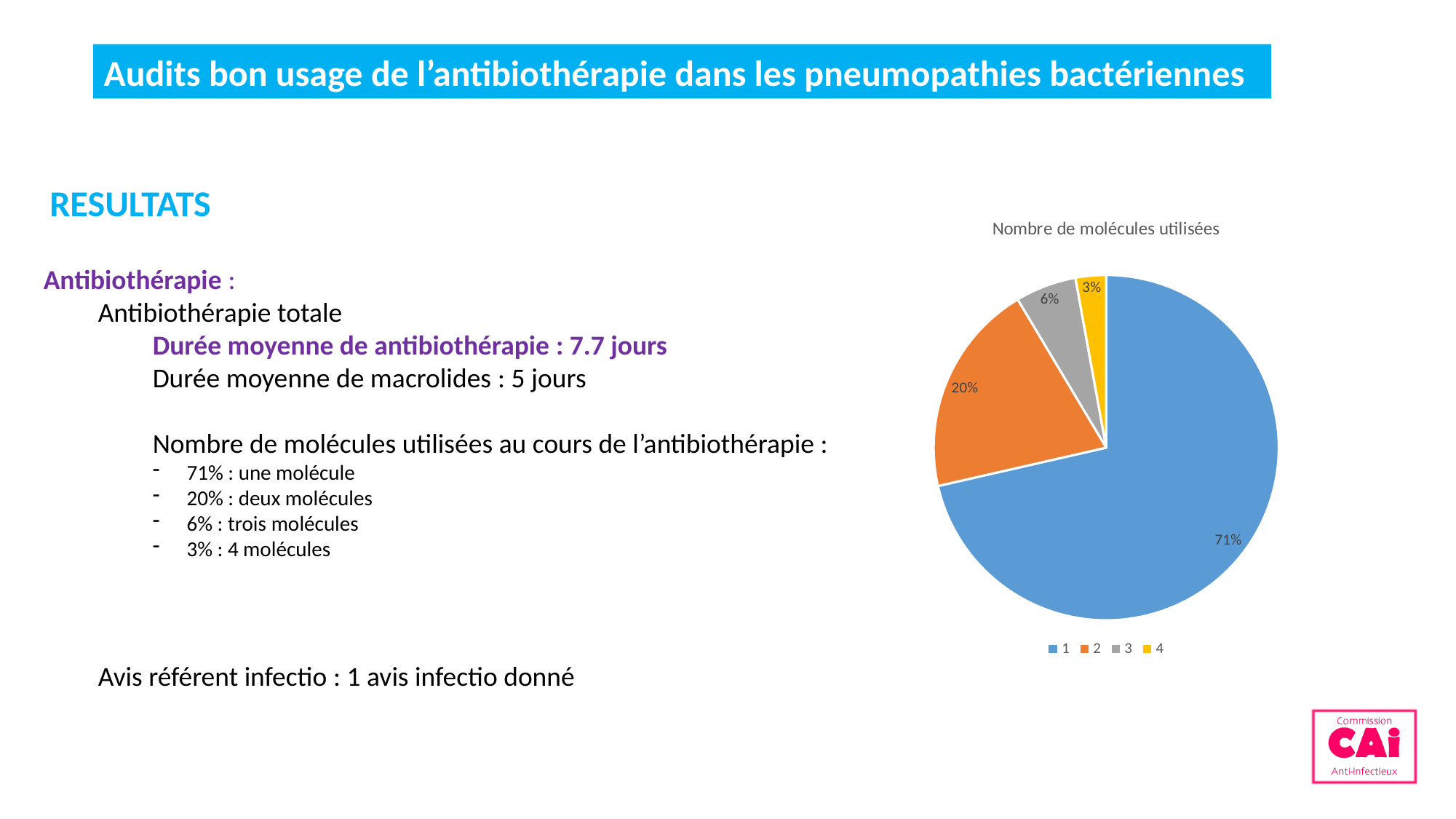
What share of the pie does category 1 represent? 71% What is the title of the chart? Nombre de molécules utilisées What is the difference in percentage points between category 1 and category 2? 51% What share of the pie does category 2 represent? 20% How many slices does the pie chart have? 4 Which category has the smallest slice of the pie? 4 What colour is the slice for category 4? yellow What share of the pie does category 3 represent? 6% Which category has the largest slice of the pie? 1 Which is larger, the slice for category 2 or the slice for category 3? 2 What type of chart is shown on the slide? pie chart